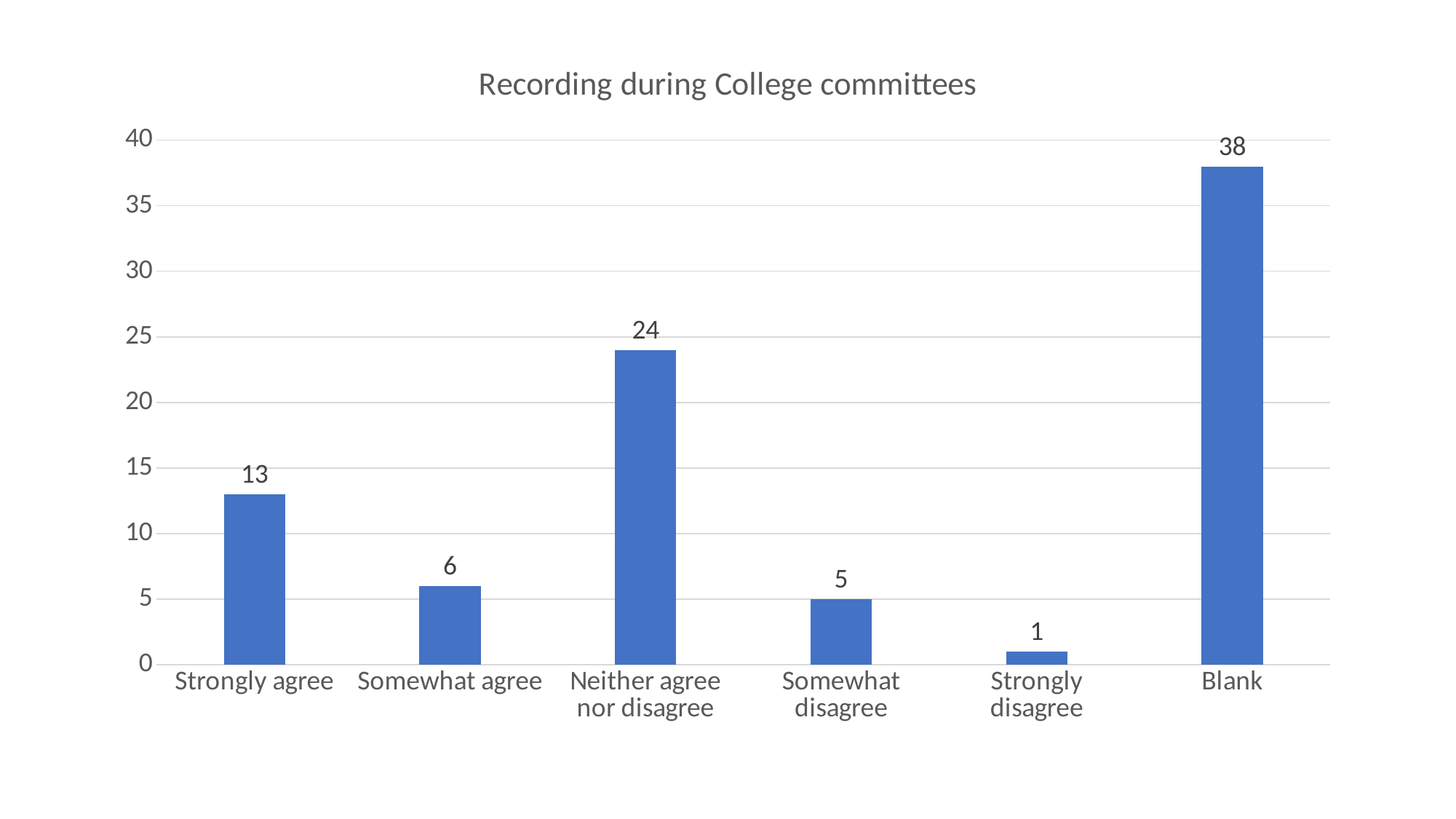
What is the difference between the values for Strongly agree and Somewhat agree? 7 What is the value for Strongly disagree? 1 What kind of chart is this? Bar chart Which category has the lowest value? Strongly disagree Which category has the highest value? Blank Which is larger, the value for Somewhat agree or the value for Somewhat disagree? Somewhat agree What is the title of the chart? Recording during College committees What is the difference between the values for Blank and Neither agree nor disagree? 14 What is the value for Strongly agree? 13 What is the value for Neither agree nor disagree? 24 What is the value for Blank? 38 How many categories are shown on the x axis? 6